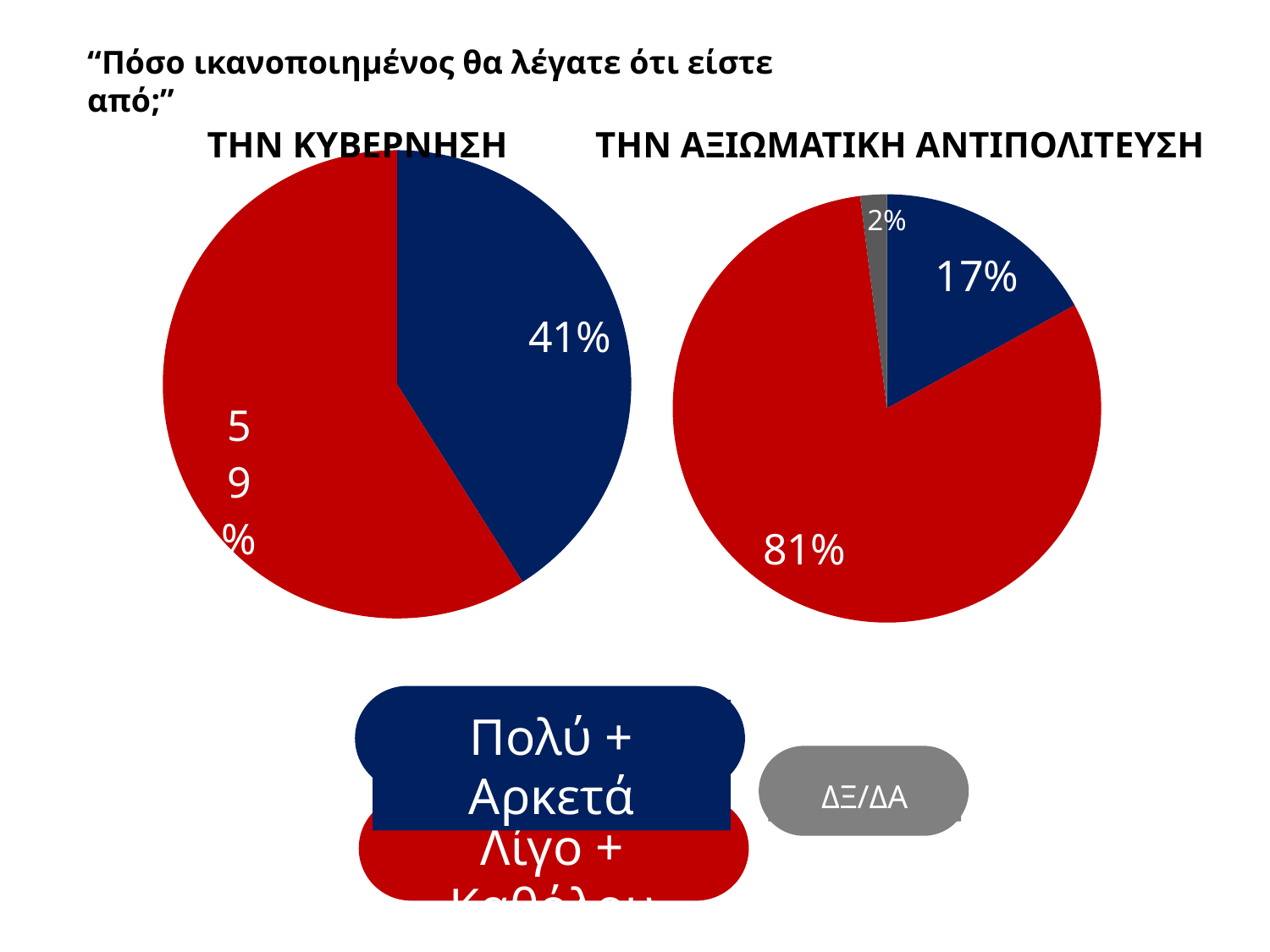
Which chart has the larger Πολύ + Αρκετά share, ΤΗΝ ΚΥΒΕΡΝΗΣΗ or ΤΗΝ ΑΞΙΩΜΑΤΙΚΗ ΑΝΤΙΠΟΛΙΤΕΥΣΗ? ΤΗΝ ΚΥΒΕΡΝΗΣΗ In the ΤΗΝ ΑΞΙΩΜΑΤΙΚΗ ΑΝΤΙΠΟΛΙΤΕΥΣΗ chart, what share is labelled for the Πολύ + Αρκετά slice? 17% In the ΤΗΝ ΚΥΒΕΡΝΗΣΗ chart, what share is labelled for the Λίγο + Καθόλου slice? 59% In the ΤΗΝ ΑΞΙΩΜΑΤΙΚΗ ΑΝΤΙΠΟΛΙΤΕΥΣΗ chart, what share is labelled for the ΔΞ/ΔΑ slice? 2% In the ΤΗΝ ΚΥΒΕΡΝΗΣΗ chart, what is the difference between the Λίγο + Καθόλου share and the Πολύ + Αρκετά share? 18% What type of chart is used on this slide? Pie chart What colour represents the ΔΞ/ΔΑ category in the legend? Grey In the ΤΗΝ ΑΞΙΩΜΑΤΙΚΗ ΑΝΤΙΠΟΛΙΤΕΥΣΗ chart, what share is labelled for the Λίγο + Καθόλου slice? 81% In the ΤΗΝ ΑΞΙΩΜΑΤΙΚΗ ΑΝΤΙΠΟΛΙΤΕΥΣΗ chart, which slice is the largest? Λίγο + Καθόλου In the ΤΗΝ ΑΞΙΩΜΑΤΙΚΗ ΑΝΤΙΠΟΛΙΤΕΥΣΗ chart, which slice is the smallest? ΔΞ/ΔΑ How many slices does the ΤΗΝ ΑΞΙΩΜΑΤΙΚΗ ΑΝΤΙΠΟΛΙΤΕΥΣΗ chart have? 3 In the ΤΗΝ ΚΥΒΕΡΝΗΣΗ chart, what share is labelled for the Πολύ + Αρκετά slice? 41%